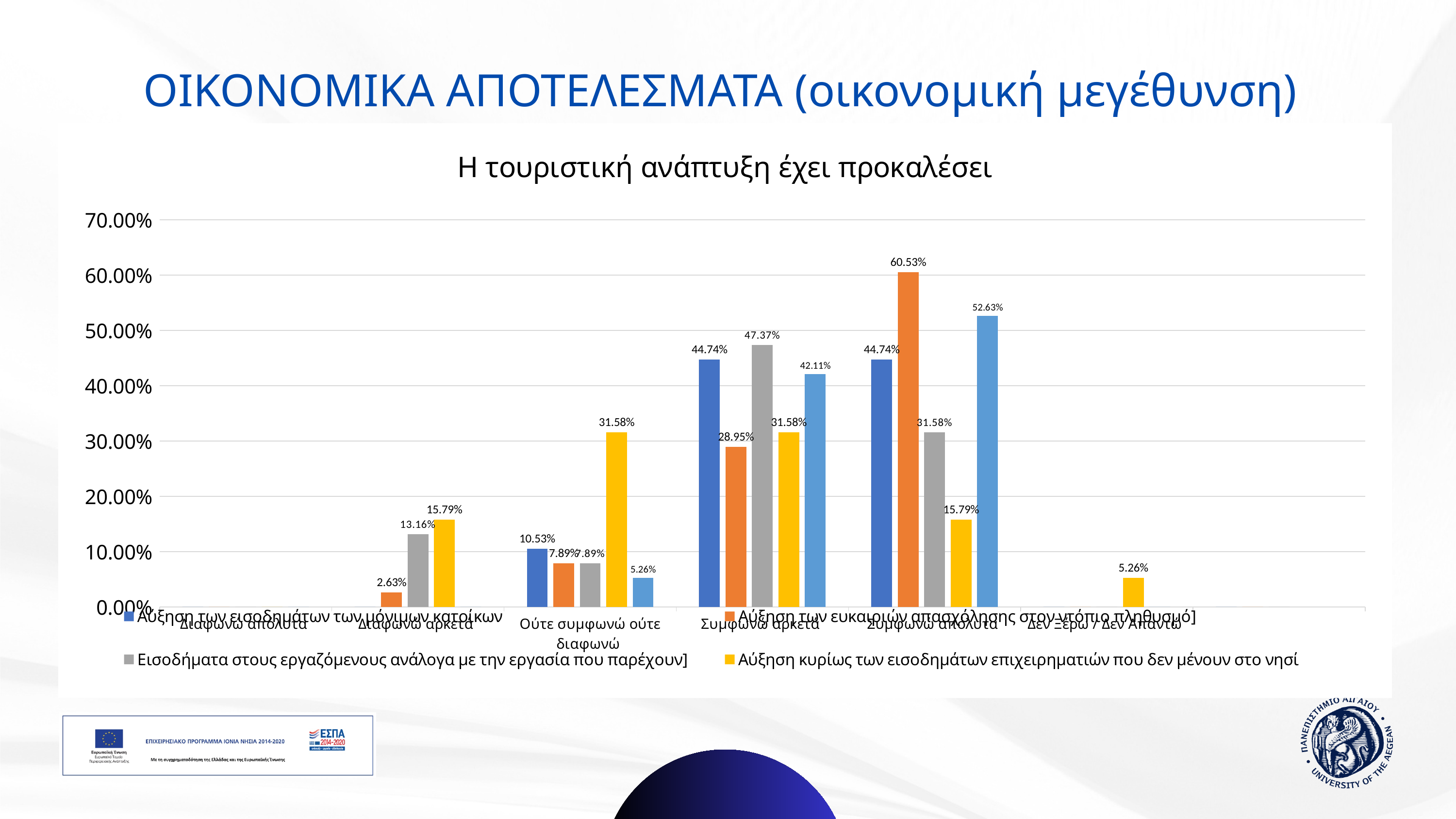
What type of chart is shown on the slide? bar chart What is the value for 'Εισοδήματα στους εργαζόμενους ανάλογα με την εργασία που παρέχουν' in the 'Συμφωνώ αρκετά' category? 47.37% What is the difference between the 'Αύξηση των ευκαιριών απασχόλησης στον ντόπιο πληθυσμό' values for 'Συμφωνώ απόλυτα' and 'Συμφωνώ αρκετά'? 31.58% In the 'Συμφωνώ απόλυτα' category, which is larger: 'Αύξηση των εισοδημάτων των μόνιμων κατοίκων' or 'Εισοδήματα στους εργαζόμενους ανάλογα με την εργασία που παρέχουν'? Αύξηση των εισοδημάτων των μόνιμων κατοίκων Which category has the lowest value for 'Αύξηση κυρίως των εισοδημάτων επιχειρηματιών που δεν μένουν στο νησί'? Διαφωνώ απόλυτα Is the value for 'Αύξηση των ευκαιριών απασχόλησης στον ντόπιο πληθυσμό' in the 'Συμφωνώ απόλυτα' category greater or less than 50.00%? greater What is the value for 'Αύξηση των ευκαιριών απασχόλησης στον ντόπιο πληθυσμό' in the 'Συμφωνώ απόλυτα' category? 60.53% How many categories are shown on the x axis? 6 What is the value for 'Αύξηση των εισοδημάτων των μόνιμων κατοίκων' in the 'Συμφωνώ αρκετά' category? 44.74% What is the chart's title? Η τουριστική ανάπτυξη έχει προκαλέσει Which category has the highest value for 'Αύξηση των ευκαιριών απασχόλησης στον ντόπιο πληθυσμό'? Συμφωνώ απόλυτα What is the value for 'Αύξηση κυρίως των εισοδημάτων επιχειρηματιών που δεν μένουν στο νησί' in the 'Ούτε συμφωνώ ούτε διαφωνώ' category? 31.58%